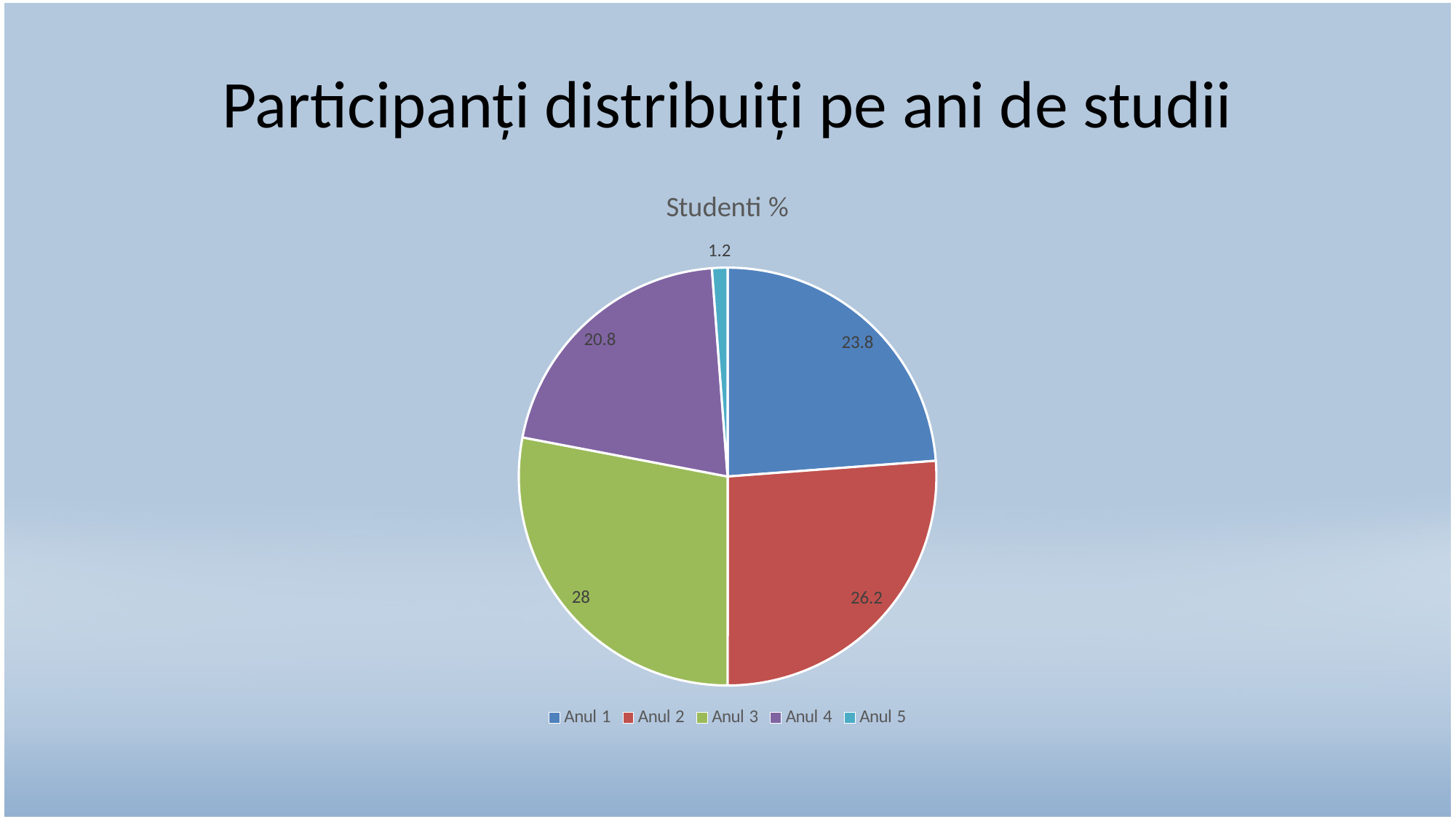
What is the value for Anul 5? 1.2 Which is larger, the value for Anul 1 or the value for Anul 4? Anul 1 What is the value for Anul 1? 23.8 What colour is the slice for Anul 2? Red What is the value for Anul 4? 20.8 What is the value for Anul 3? 28 How many categories does the pie chart show? 5 Which year has the largest share of students? Anul 3 What is the title of the chart? Studenti % What is the difference between the values for Anul 3 and Anul 2? 1.8 Which year has the smallest share of students? Anul 5 What kind of chart is shown on the slide? Pie chart